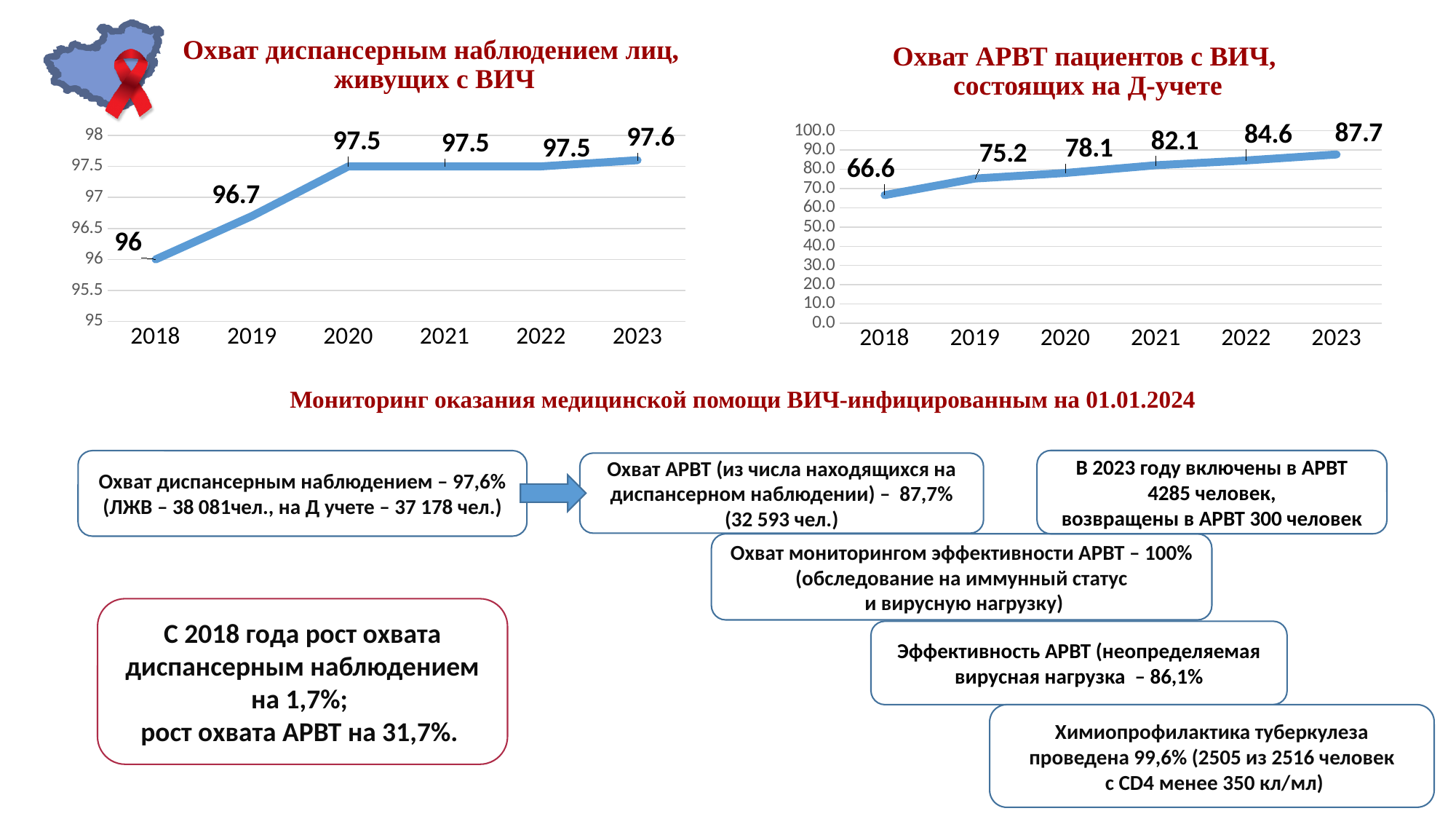
In the left chart (Охват диспансерным наблюдением лиц, живущих с ВИЧ), what is the value for 2019? 96.7 In the left chart (Охват диспансерным наблюдением лиц, живущих с ВИЧ), which year has the highest value? 2023 In the left chart (Охват диспансерным наблюдением лиц, живущих с ВИЧ), which year has the lowest value? 2018 How many years are plotted in the right chart (Охват АРВТ пациентов с ВИЧ, состоящих на Д-учете)? 6 In the right chart (Охват АРВТ пациентов с ВИЧ, состоящих на Д-учете), what is the difference between the 2023 value and the 2022 value? 3.1 In the left chart (Охват диспансерным наблюдением лиц, живущих с ВИЧ), what is the value for 2018? 96 In the right chart (Охват АРВТ пациентов с ВИЧ, состоящих на Д-учете), what is the value for 2018? 66.6 In the right chart (Охват АРВТ пациентов с ВИЧ, состоящих на Д-учете), do the values rise or fall from 2018 to 2023? rise In the left chart (Охват диспансерным наблюдением лиц, живущих с ВИЧ), what is the difference between the 2023 value and the 2018 value? 1.6 In the right chart (Охват АРВТ пациентов с ВИЧ, состоящих на Д-учете), what is the value for 2021? 82.1 What kind of chart is the left chart (Охват диспансерным наблюдением лиц, живущих с ВИЧ)? line chart In the right chart (Охват АРВТ пациентов с ВИЧ, состоящих на Д-учете), is the value for 2019 larger or the value for 2020? 2020